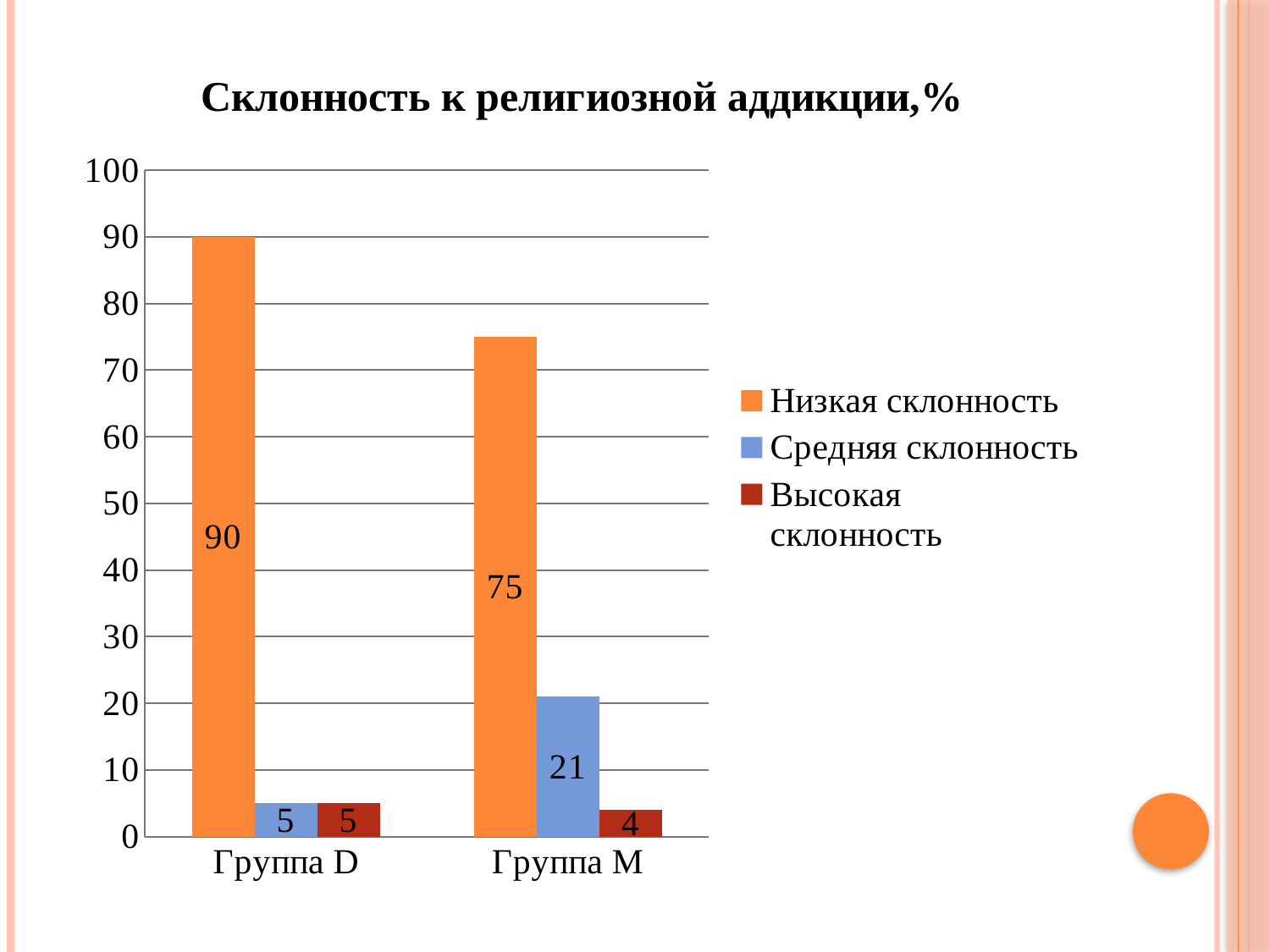
What is the title of the chart? Склонность к религиозной аддикции,% What kind of chart is shown on the slide? Bar chart Which group has the higher value for Низкая склонность? Группа D Which series has the lowest value for Группа М? Высокая склонность What is the difference between the Низкая склонность values for Группа D and Группа М? 15 What is the value of Низкая склонность for Группа D? 90 What is the value of Средняя склонность for Группа М? 21 Is the Средняя склонность value larger for Группа D or Группа М? Группа М How many groups are shown on the x axis? 2 What is the value of Высокая склонность for Группа М? 4 How many series does the legend list? 3 What is the value of Низкая склонность for Группа М? 75